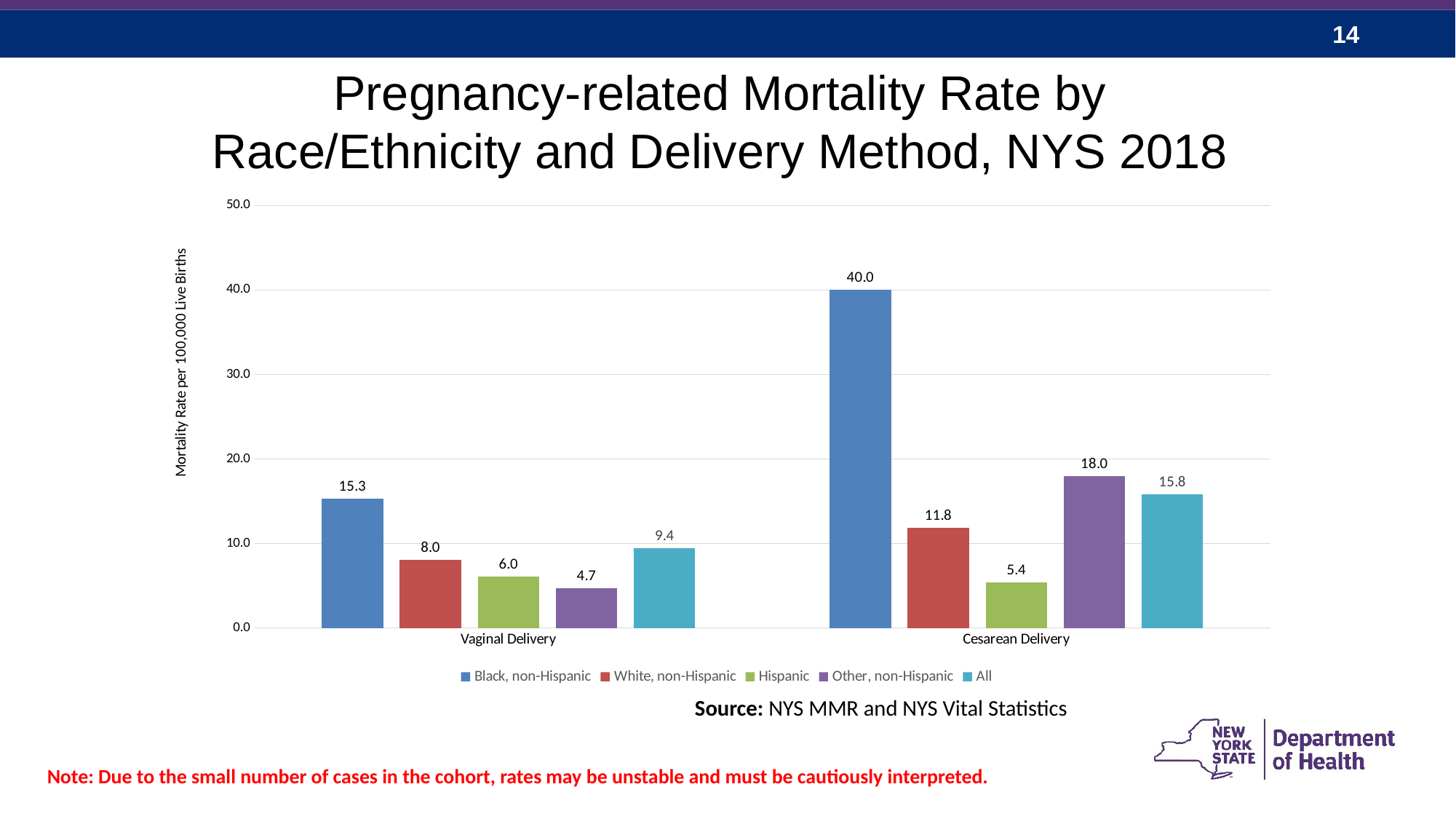
How many series does the legend list? 5 Which race/ethnicity group has the lowest mortality rate for Cesarean Delivery? Hispanic What is the label of the y axis? Mortality Rate per 100,000 Live Births Which race/ethnicity group has the highest mortality rate for Vaginal Delivery? Black, non-Hispanic Is the mortality rate for Other, non-Hispanic women with Vaginal Delivery greater or less than 10.0? less How many delivery method categories are shown on the x axis? 2 What is the mortality rate for the All group with Cesarean Delivery? 15.8 Which is larger: the White, non-Hispanic rate for Cesarean Delivery or the Other, non-Hispanic rate for Cesarean Delivery? Other, non-Hispanic rate for Cesarean Delivery What is the pregnancy-related mortality rate for Black, non-Hispanic women with Cesarean Delivery? 40.0 What kind of chart is shown on the slide? Bar chart What is the mortality rate for Hispanic women with Vaginal Delivery? 6.0 What is the difference between the Black, non-Hispanic mortality rate for Cesarean Delivery and for Vaginal Delivery? 24.7